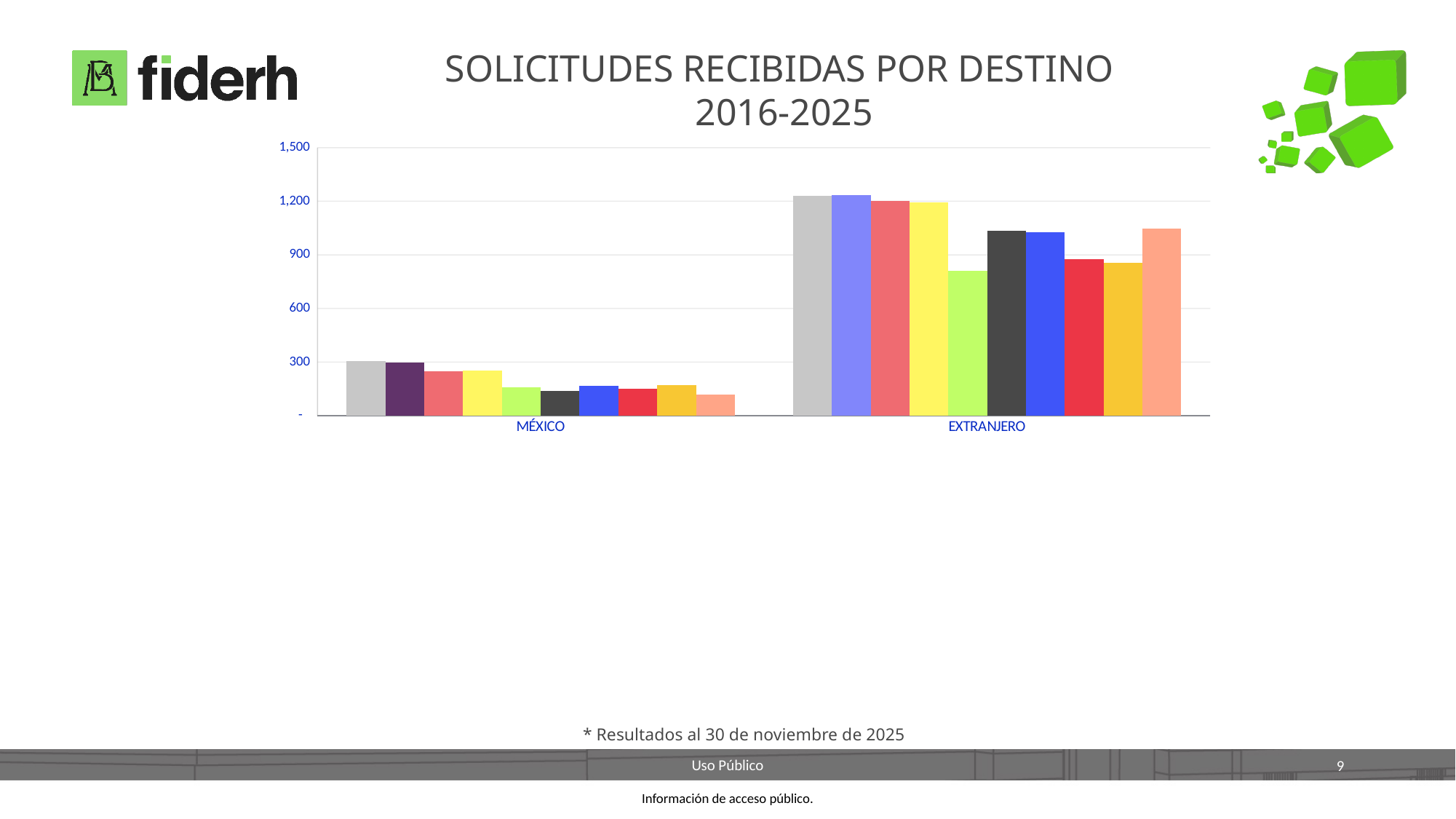
Is the value of the last (salmon) bar in the EXTRANJERO group greater or less than 900? greater How many bars are plotted in the MÉXICO group? 10 Is the value of the first (grey) bar in the EXTRANJERO group greater or less than 900? greater Is the value of the first (grey) bar in the MÉXICO group greater or less than 600? less Which category has the taller bars overall, MÉXICO or EXTRANJERO? EXTRANJERO What kind of chart is shown on the slide? bar chart How many destination categories are shown on the x axis of the chart? 2 What are the two categories labelled on the x axis of the chart? MÉXICO and EXTRANJERO What is the highest value shown on the vertical axis of the chart? 1,500 How many bars are plotted in the EXTRANJERO group? 10